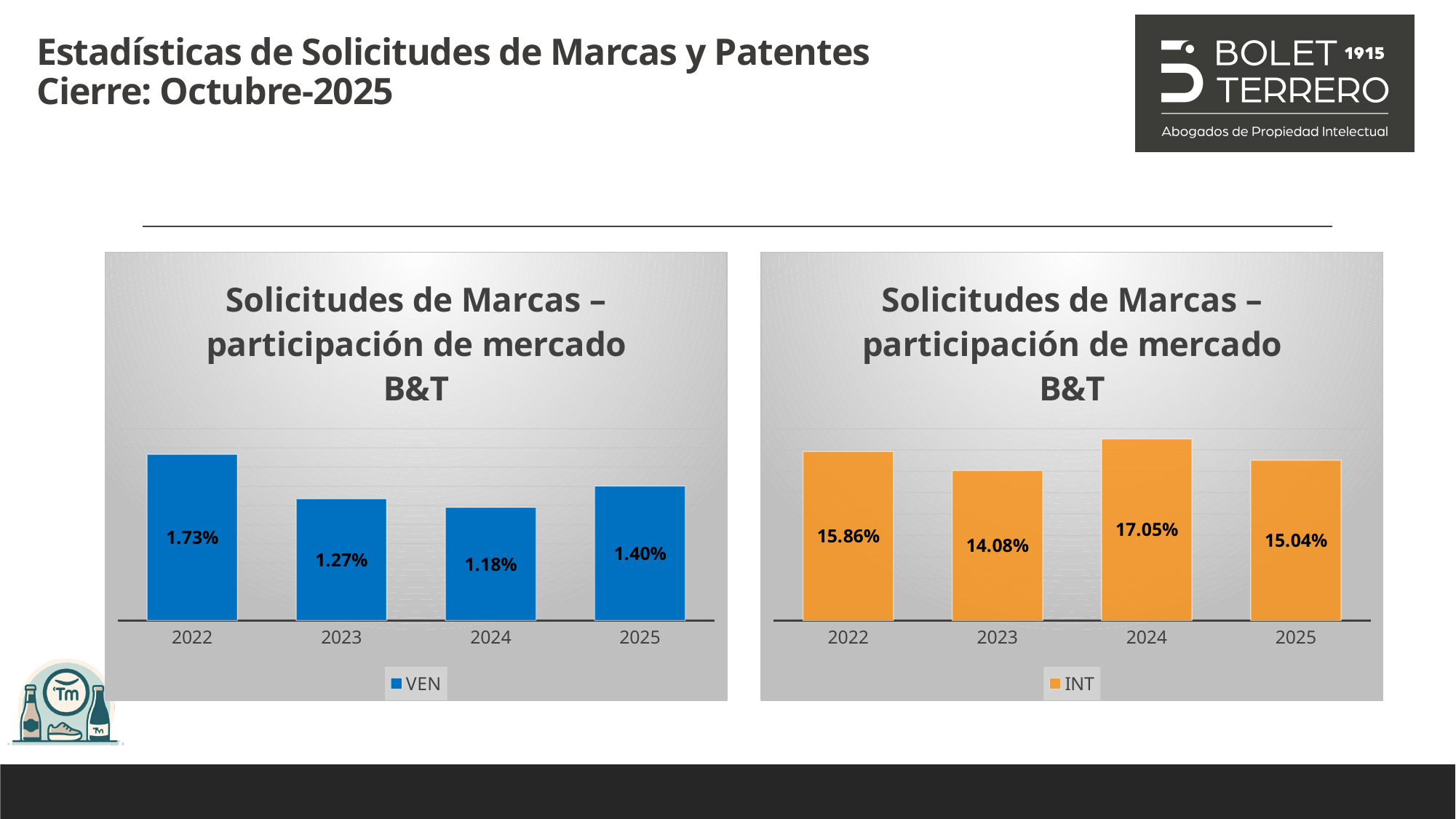
In the right chart (INT), which year has the highest value? 2024 In the left chart (VEN), what is the difference between the 2022 value and the 2024 value? 0.55% In the left chart (VEN), do the values rise or fall from 2022 to 2024? fall In the left chart (VEN), which is larger, the value for 2023 or the value for 2025? 2025 In the left chart (VEN), which year has the lowest value? 2024 In the right chart (INT), what is the difference between the 2024 value and the 2023 value? 2.97% In the right chart (INT), what is the value for 2024? 17.05% In the left chart (VEN), what is the value for 2022? 1.73% What series name does the legend of the right chart list? INT How many years are shown on the x axis of the right chart (INT)? 4 What kind of chart is the left chart (VEN)? bar chart In the right chart (INT), which year has the lowest value? 2023